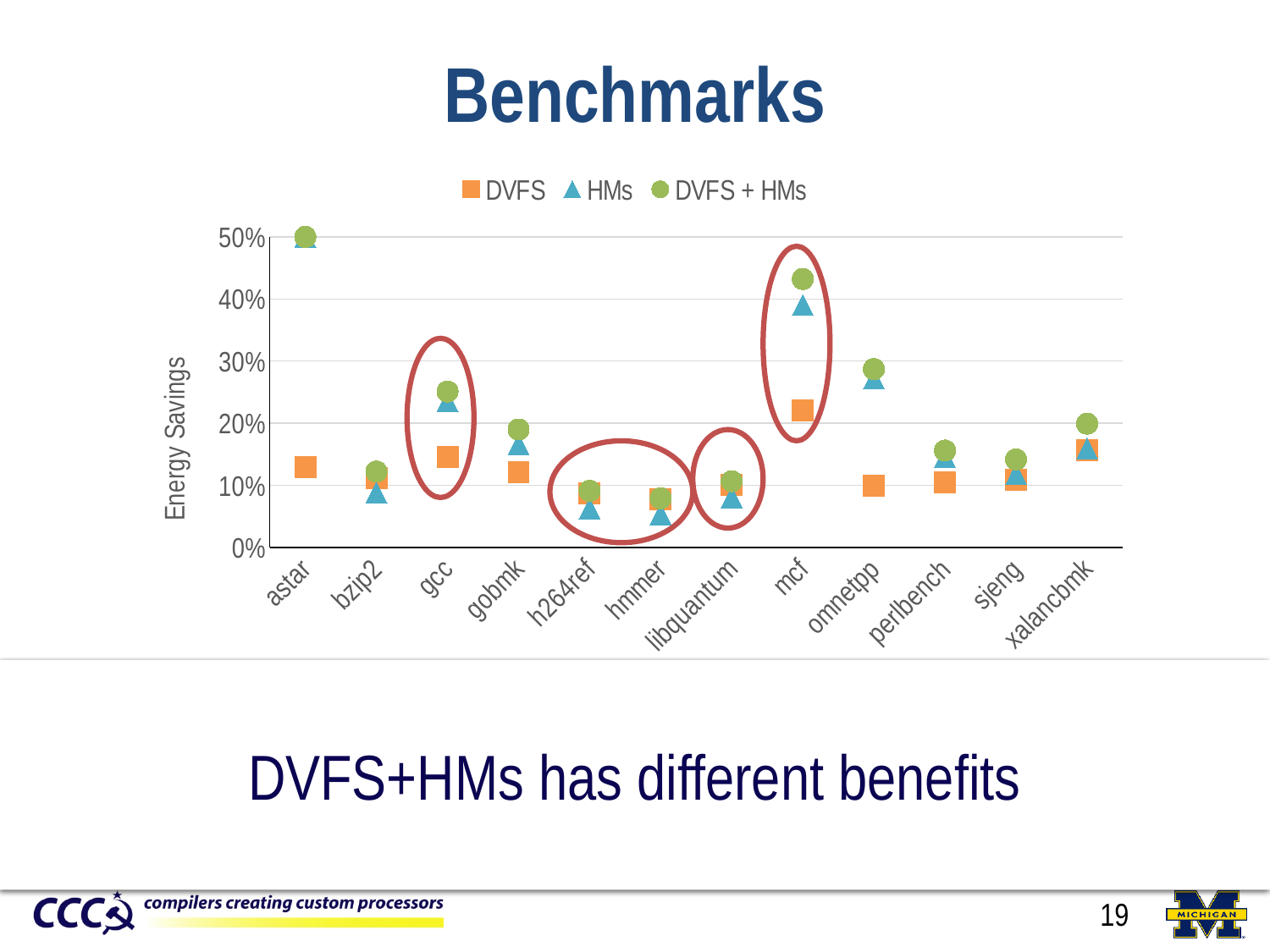
Which benchmark has the highest DVFS energy savings? mcf Which benchmark has the highest DVFS + HMs energy savings? astar Is the HMs value for h264ref greater or less than 10%? less Which series is shown with green circle markers? DVFS + HMs For mcf, which is larger: the HMs value or the DVFS value? HMs What kind of chart is this? scatter chart Is the DVFS + HMs value for mcf greater or less than 40%? greater Is the DVFS + HMs value for gcc greater or less than 20%? greater How many benchmarks are shown on the x axis? 12 What is the label of the y axis? Energy Savings How many series does the legend list? 3 Which has the larger DVFS + HMs value: mcf or omnetpp? mcf